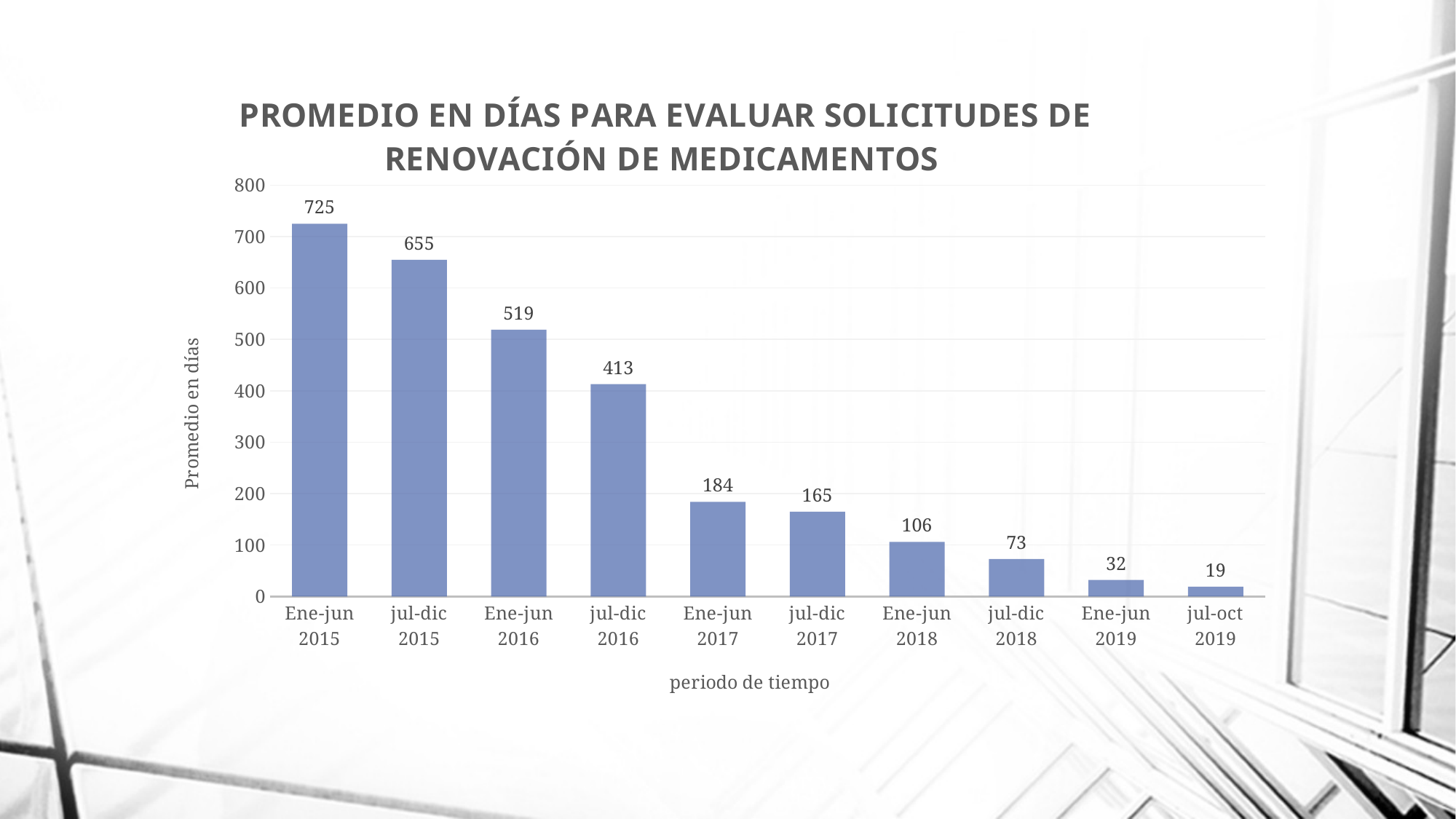
Do the values rise or fall from left to right along the x axis? Fall What is the difference between the values for Ene-jun 2015 and jul-dic 2015? 70 How many periods are shown on the x axis? 10 What is the value for Ene-jun 2018? 106 What kind of chart is shown on the slide? Bar chart Which period has the highest value? Ene-jun 2015 Which is larger, the value for Ene-jun 2016 or the value for jul-dic 2016? Ene-jun 2016 What is the value for jul-dic 2016? 413 What is the value for jul-oct 2019? 19 What is the difference between the values for Ene-jun 2017 and jul-dic 2017? 19 Which period has the lowest value? jul-oct 2019 What is the value for Ene-jun 2015? 725